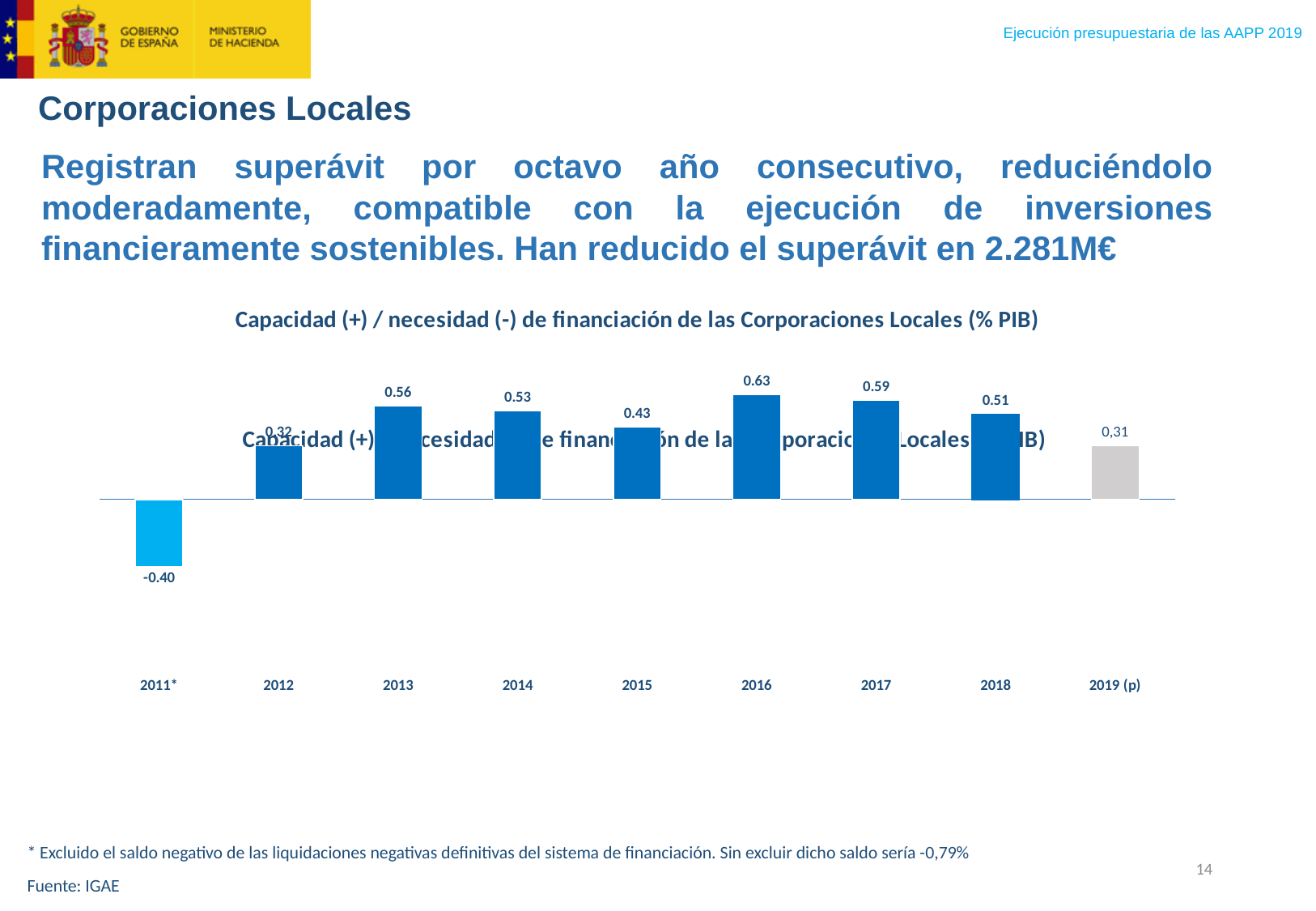
Do the values rise or fall from 2016 to 2019 (p)? Fall What is the difference between the values for 2016 and 2017? 0.04 What is the value for 2015? 0.43 What is the value for 2019 (p)? 0,31 How many years are shown on the x axis? 9 Which year has the lowest value? 2011* Which year has the highest value? 2016 What is the value for 2016? 0.63 What kind of chart is shown? Bar chart What is the difference between the values for 2013 and 2015? 0.13 Which is larger, the value for 2013 or the value for 2014? 2013 What is the value for 2011*? -0.40